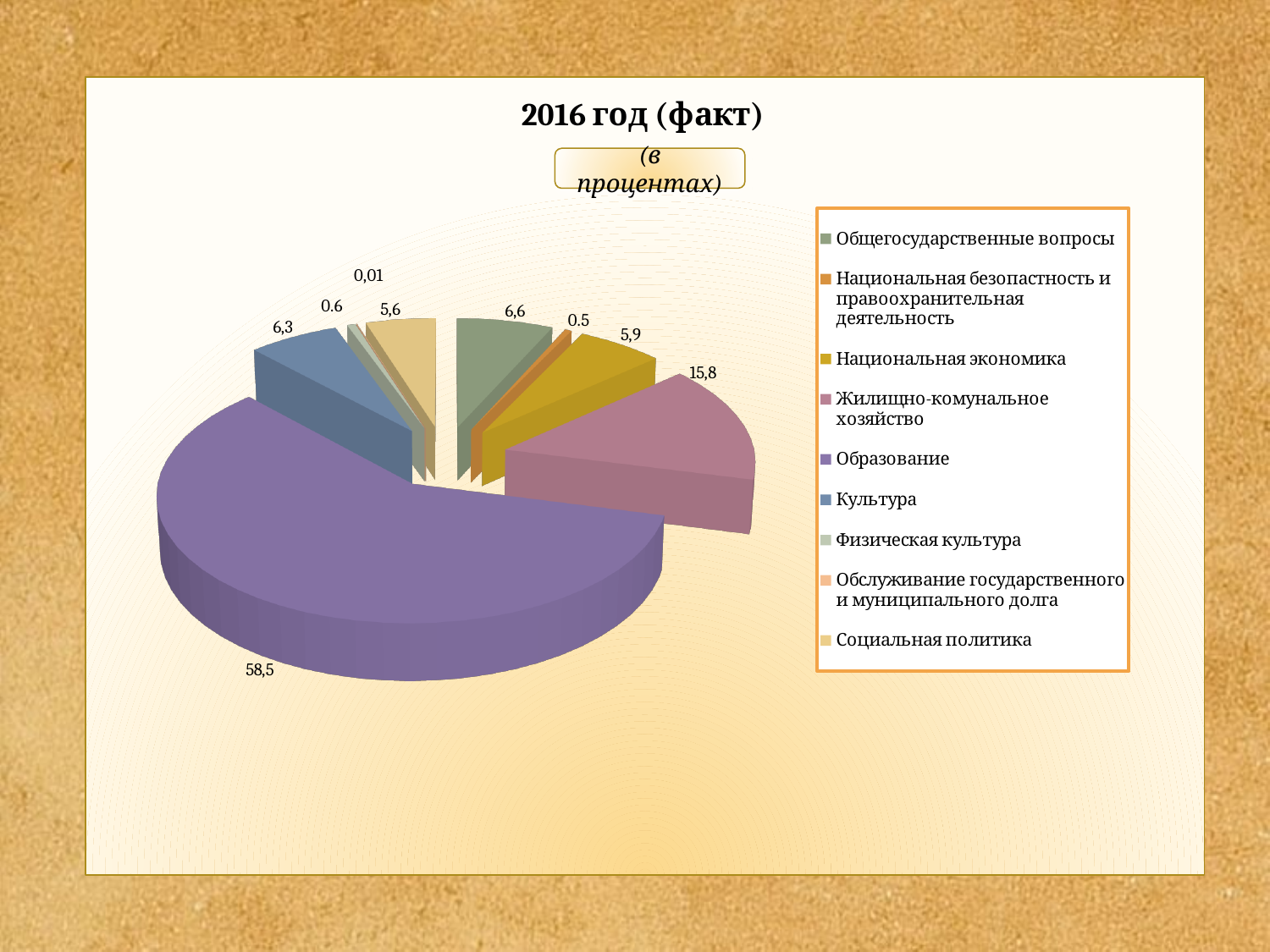
Which category has the smallest share of the pie? Обслуживание государственного и муниципального долга What is the value for Культура? 6,3 What kind of chart is shown on the slide? Pie chart How many entries does the legend list? 9 What is the value for Обслуживание государственного и муниципального долга? 0,01 Which category has the largest share of the pie? Образование What is the value for Жилищно-комунальное хозяйство? 15,8 What is the value for Образование? 58,5 Which is larger, the value for Национальная экономика or the value for Культура? Культура What is the value for Социальная политика? 5,6 What is the value for Общегосударственные вопросы? 6,6 What is the title of the chart? 2016 год (факт)